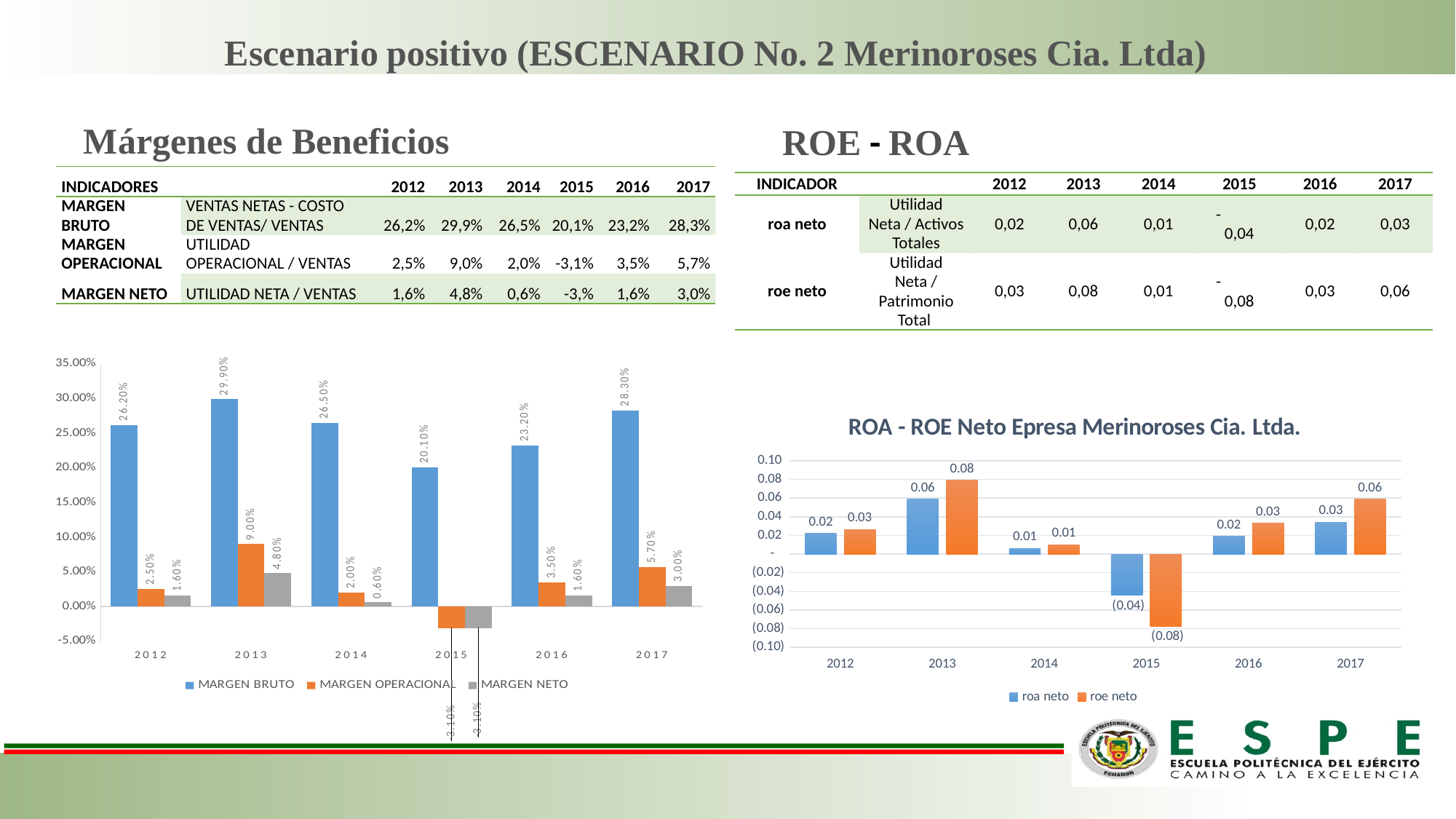
In the left chart (Márgenes de Beneficios), what is the value of MARGEN BRUTO for 2013? 29.90% In the chart titled 'ROA - ROE Neto Epresa Merinoroses Cia. Ltda.', what colour are the roe neto bars? Orange In the chart titled 'ROA - ROE Neto Epresa Merinoroses Cia. Ltda.', how many years are shown on the x axis? 6 In the left chart (Márgenes de Beneficios), which year has the lowest MARGEN BRUTO? 2015 In the chart titled 'ROA - ROE Neto Epresa Merinoroses Cia. Ltda.', what is the value of roa neto for 2015? (0.04) In the chart titled 'ROA - ROE Neto Epresa Merinoroses Cia. Ltda.', what is the value of roe neto for 2013? 0.08 In the chart titled 'ROA - ROE Neto Epresa Merinoroses Cia. Ltda.', which is larger in 2017, roa neto or roe neto? roe neto In the left chart (Márgenes de Beneficios), what is the difference between MARGEN BRUTO in 2013 and in 2012? 3.70% In the left chart (Márgenes de Beneficios), how many series does the legend list? 3 In the left chart (Márgenes de Beneficios), what is the value of MARGEN OPERACIONAL for 2017? 5.70% In the left chart (Márgenes de Beneficios), which year has the highest MARGEN BRUTO? 2013 In the left chart (Márgenes de Beneficios), what kind of chart is shown? Bar chart